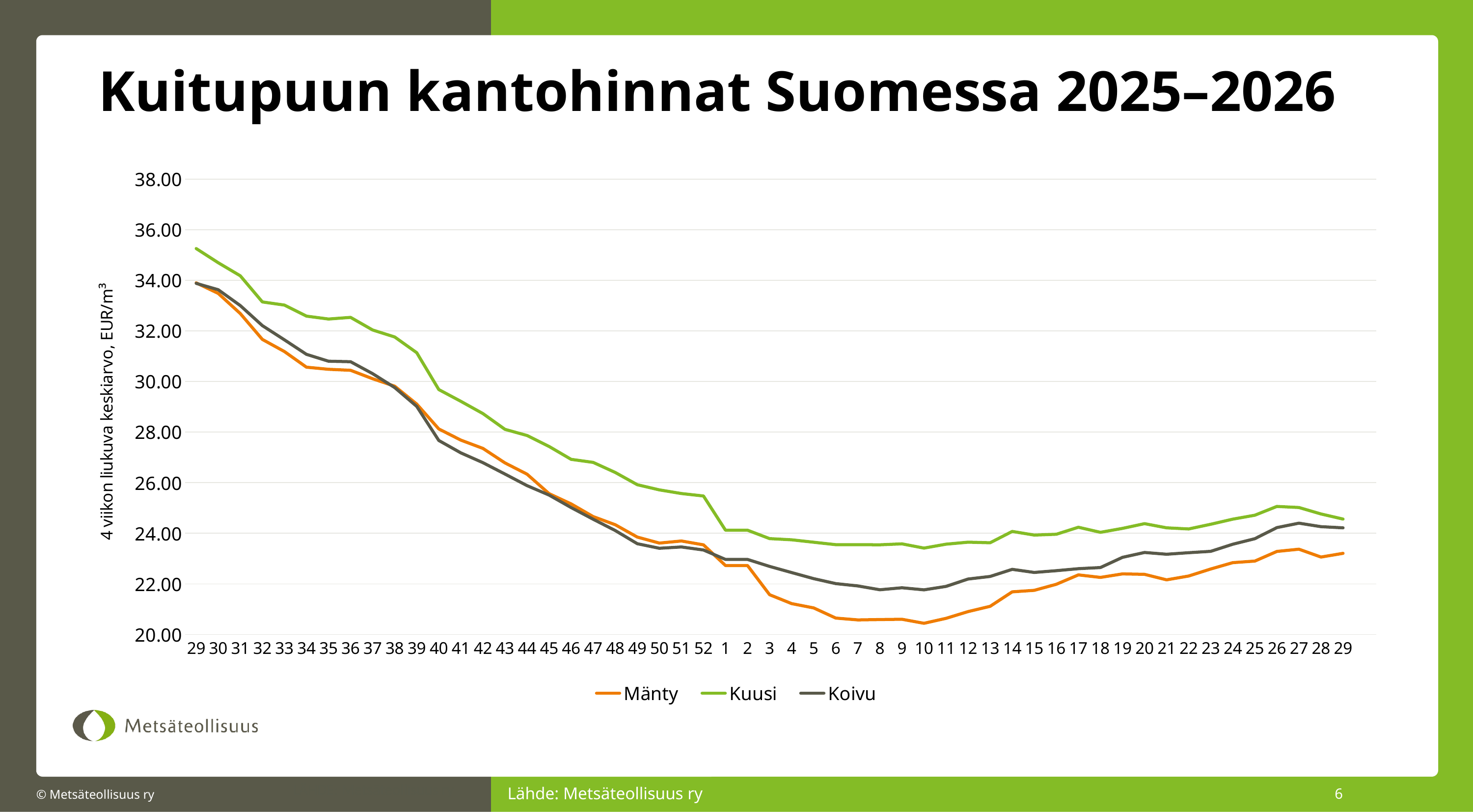
Is the value for Kuusi at week 52 greater or less than 24.00? greater Which series has the lowest value at week 20? Mänty Is the value for Koivu at week 29 (the first point) greater or less than 32.00? greater What is the label of the vertical axis? 4 viikon liukuva keskiarvo, EUR/m³ At week 10, which is larger, the value for Kuusi or the value for Mänty? Kuusi Is the value for Kuusi at week 29 (the first point) greater or less than 34.00? greater Which series has the highest value at week 20? Kuusi How many series does the legend list? 3 Does the Mänty line rise or fall from week 29 to week 10? fall What kind of chart is shown on the slide? line chart Which series are listed in the legend? Mänty, Kuusi, Koivu